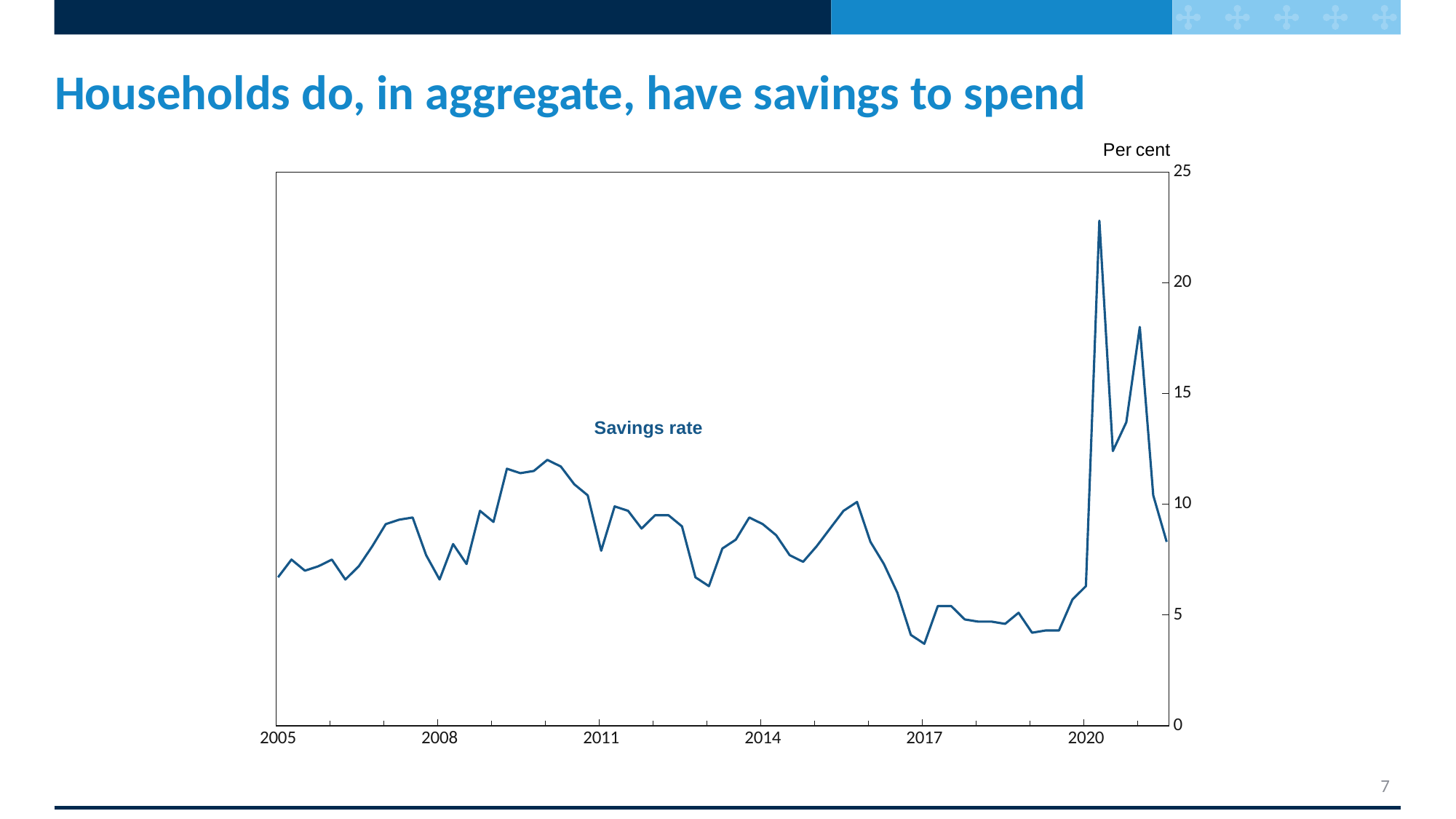
Is the savings rate at the start of 2020 greater or less than 10? less Around which year labelled on the x axis does the savings rate reach its highest value? 2020 Does the savings rate rise or fall between the start of 2017 and its peak in 2020? rise What kind of chart is shown on the slide? line chart What is the name of the series plotted on the chart? Savings rate Is the savings rate at the start of 2005 greater or less than 5? greater Is the peak value of the savings rate in 2020 greater or less than 20? greater Which is larger: the savings rate at the start of 2011 or at the start of 2017? 2011 What is the title of the slide containing the chart? Households do, in aggregate, have savings to spend Around which year labelled on the x axis does the savings rate reach its lowest value? 2017